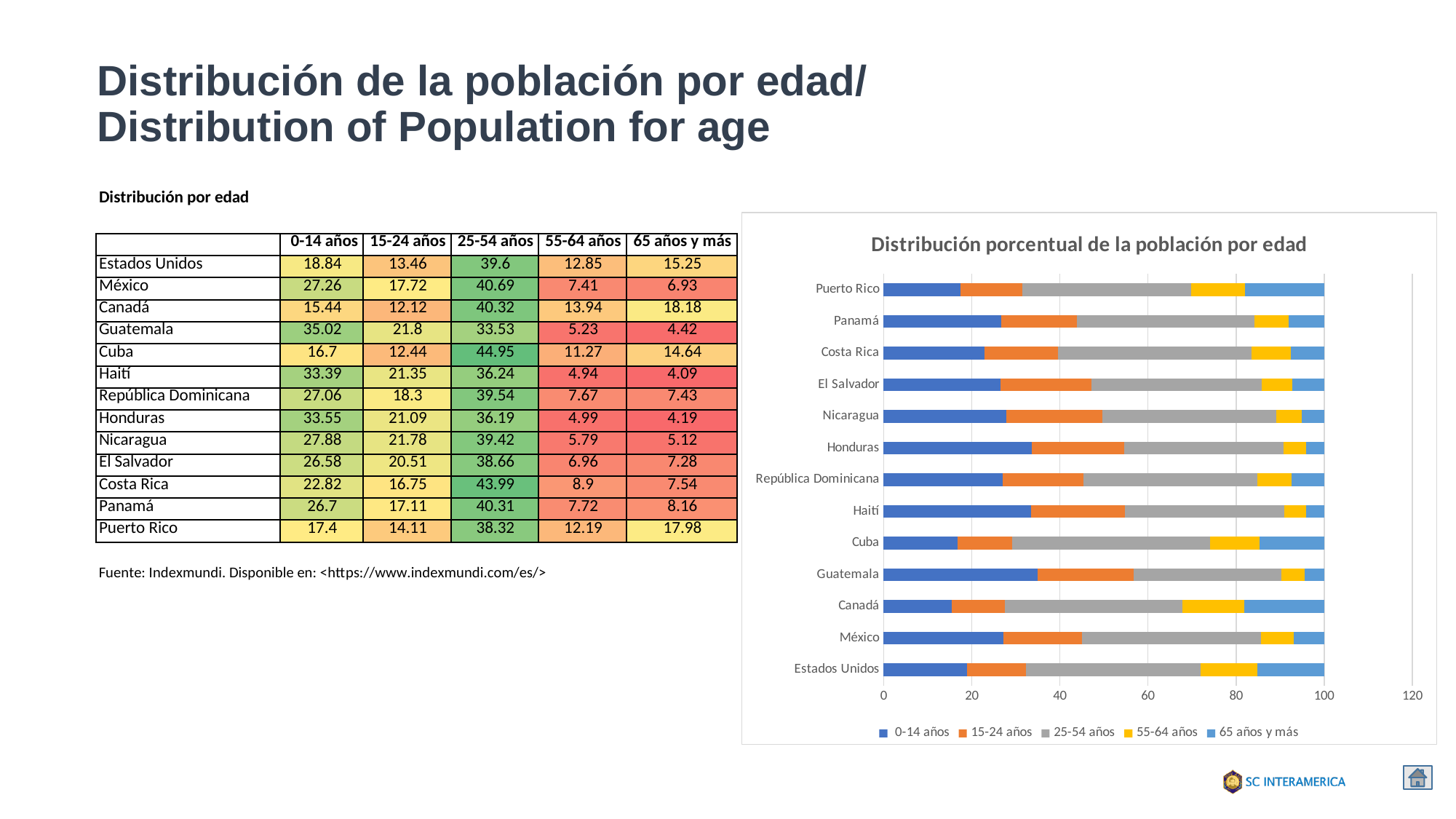
Which country has the largest 0-14 años share in the chart? Guatemala What colour represents the 25-54 años series in the chart legend? grey In the chart, is the 0-14 años value for Guatemala greater or less than 30? greater How many series does the legend of the chart 'Distribución porcentual de la población por edad' list? 5 What kind of chart is shown on the right of the slide? bar chart In the chart, is the 25-54 años value for Cuba greater or less than 40? greater What is the total of the stacked bar for Estados Unidos in the chart? 100 What is the 25-54 años value for Cuba shown on the slide? 44.95 What is the title of the chart on the right of the slide? Distribución porcentual de la población por edad In the chart, is the 0-14 años value for Canadá greater or less than 20? less How many countries are plotted in the chart 'Distribución porcentual de la población por edad'? 13 Which is larger in the chart: the 0-14 años share for Guatemala or for Canadá? Guatemala